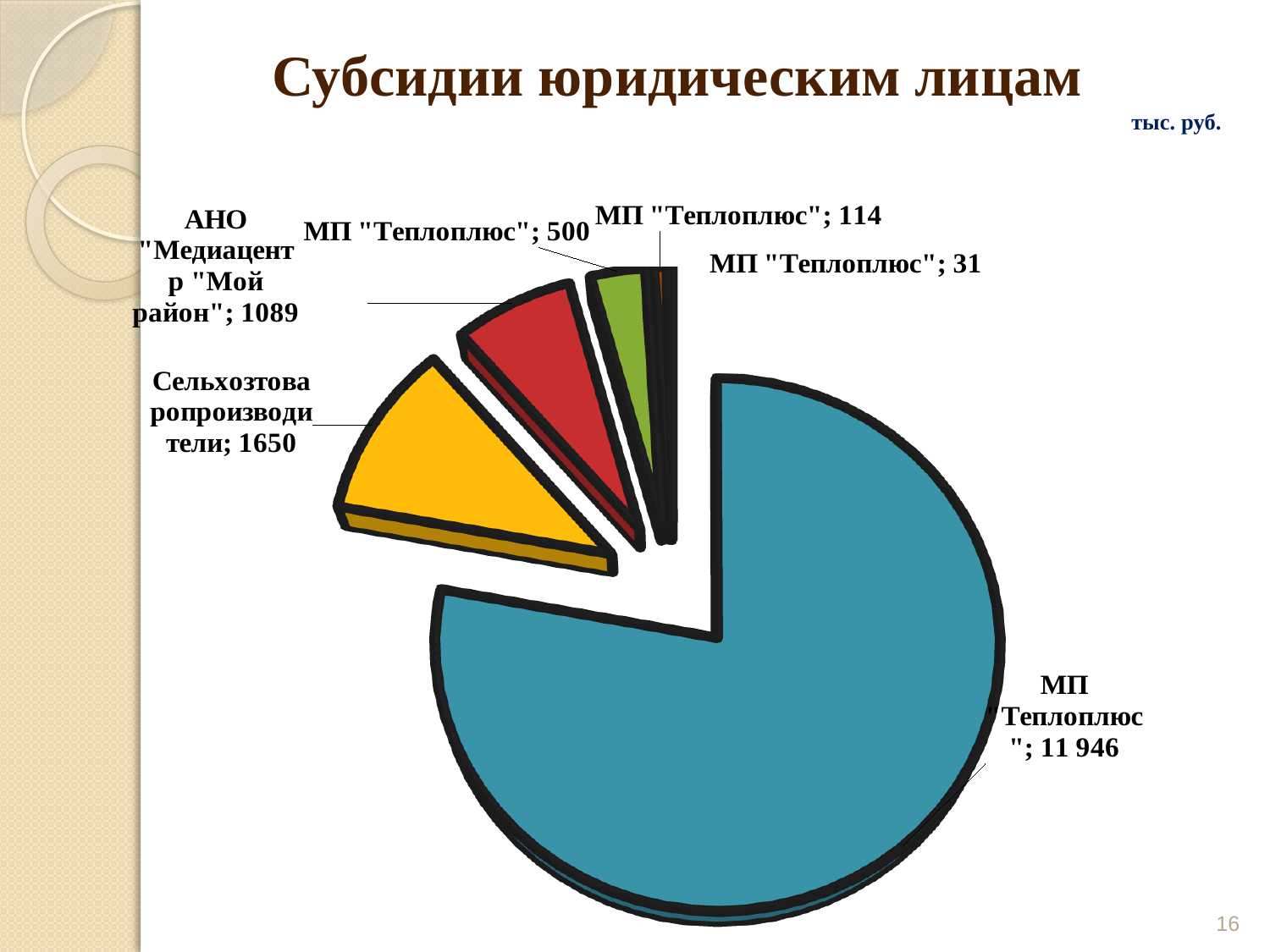
What is the difference between the value for Сельхозтоваропроизводители and the value for АНО "Медиацентр "Мой район"? 561 What is the total of all the values shown on the pie chart? 15 330 What is the value for АНО "Медиацентр "Мой район"? 1089 How many slices does the pie chart have? 6 What kind of chart is shown on the slide? pie chart Which category has the largest slice of the pie? МП "Теплоплюс" (11 946) Which is larger: the value for Сельхозтоваропроизводители or the value for АНО "Медиацентр "Мой район"? Сельхозтоваропроизводители What is the title of the chart? Субсидии юридическим лицам What is the value of the largest slice of the pie? 11 946 What is the value of the smallest slice of the pie? 31 In what units are the values on the chart given? тыс. руб. What is the value for Сельхозтоваропроизводители? 1650